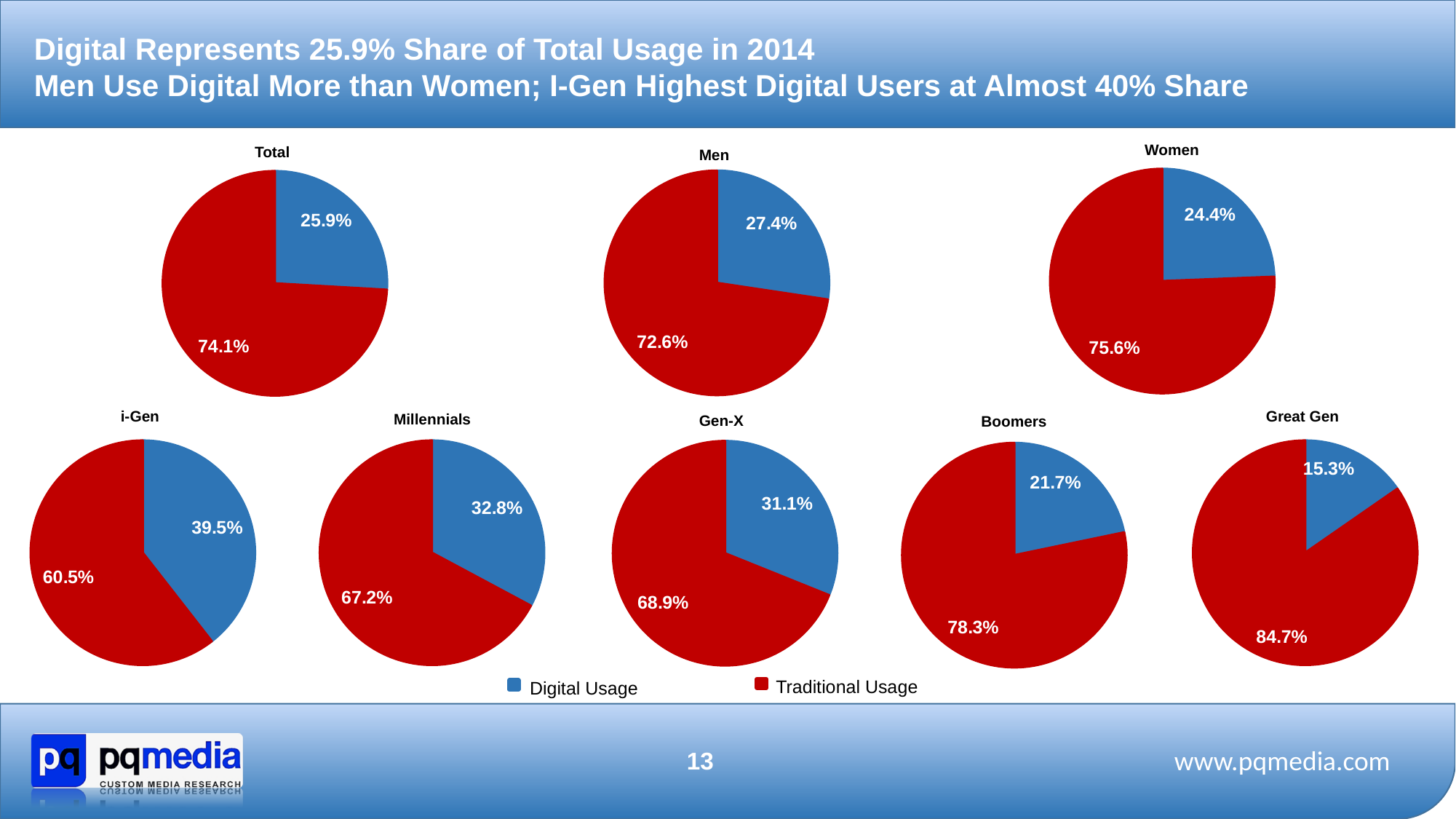
How many pie charts are shown on the slide? 8 In the Great Gen pie chart, what share is Traditional Usage? 84.7% Which is larger: the Digital Usage share in the Millennials pie chart or the Digital Usage share in the Gen-X pie chart? Millennials Across the generation pie charts (i-Gen, Millennials, Gen-X, Boomers, Great Gen), which generation has the lowest Digital Usage share? Great Gen What type of chart is used for the Total chart? Pie chart In the Total pie chart, what share is Digital Usage? 25.9% What is the difference between the Digital Usage share in the Men pie chart and the Digital Usage share in the Women pie chart? 3.0% What is the difference between the Traditional Usage share in the Boomers pie chart and the Traditional Usage share in the i-Gen pie chart? 17.8% In the Men pie chart, what share is Traditional Usage? 72.6% Across the generation pie charts (i-Gen, Millennials, Gen-X, Boomers, Great Gen), which generation has the highest Digital Usage share? i-Gen How many series does the legend list? 2 In the Women pie chart, what share is Digital Usage? 24.4%